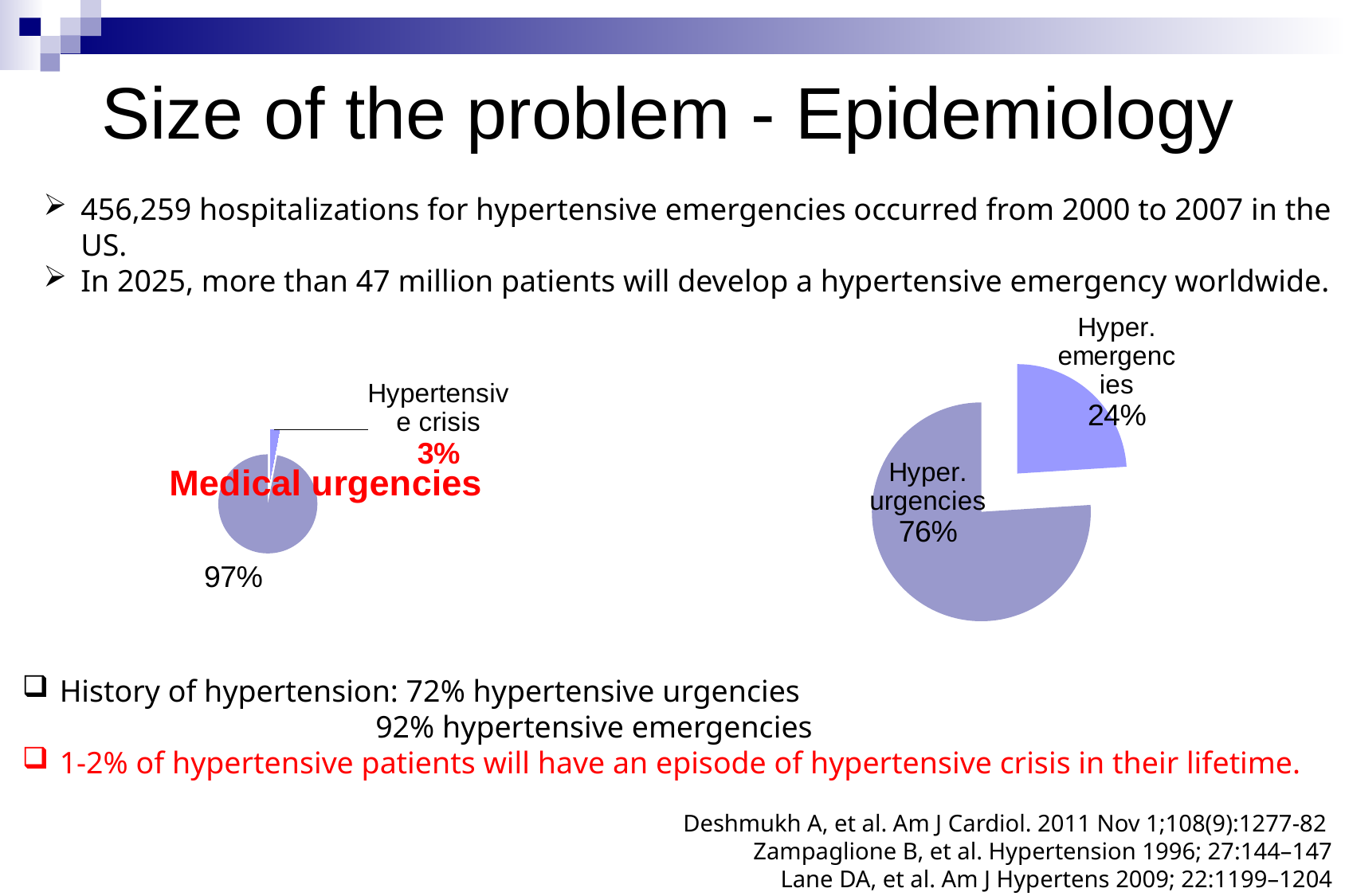
How many slices does the left pie chart have? 2 In the right pie chart, what is the difference between the Hyper. urgencies share and the Hyper. emergencies share? 52% In the left pie chart, which slice is the largest? Medical urgencies In the right pie chart, what share is labelled for Hyper. urgencies? 76% In the left pie chart, what share is labelled for Hypertensive crisis? 3% What kind of chart is the left chart on the slide? pie chart In the left pie chart, what is the difference between the Medical urgencies share and the Hypertensive crisis share? 94% In the right pie chart, what share is labelled for Hyper. emergencies? 24% In the left pie chart, which slice is the smallest? Hypertensive crisis In the right pie chart, which slice is larger, Hyper. urgencies or Hyper. emergencies? Hyper. urgencies In the left pie chart, what share is labelled for Medical urgencies? 97% How many slices does the right pie chart have? 2